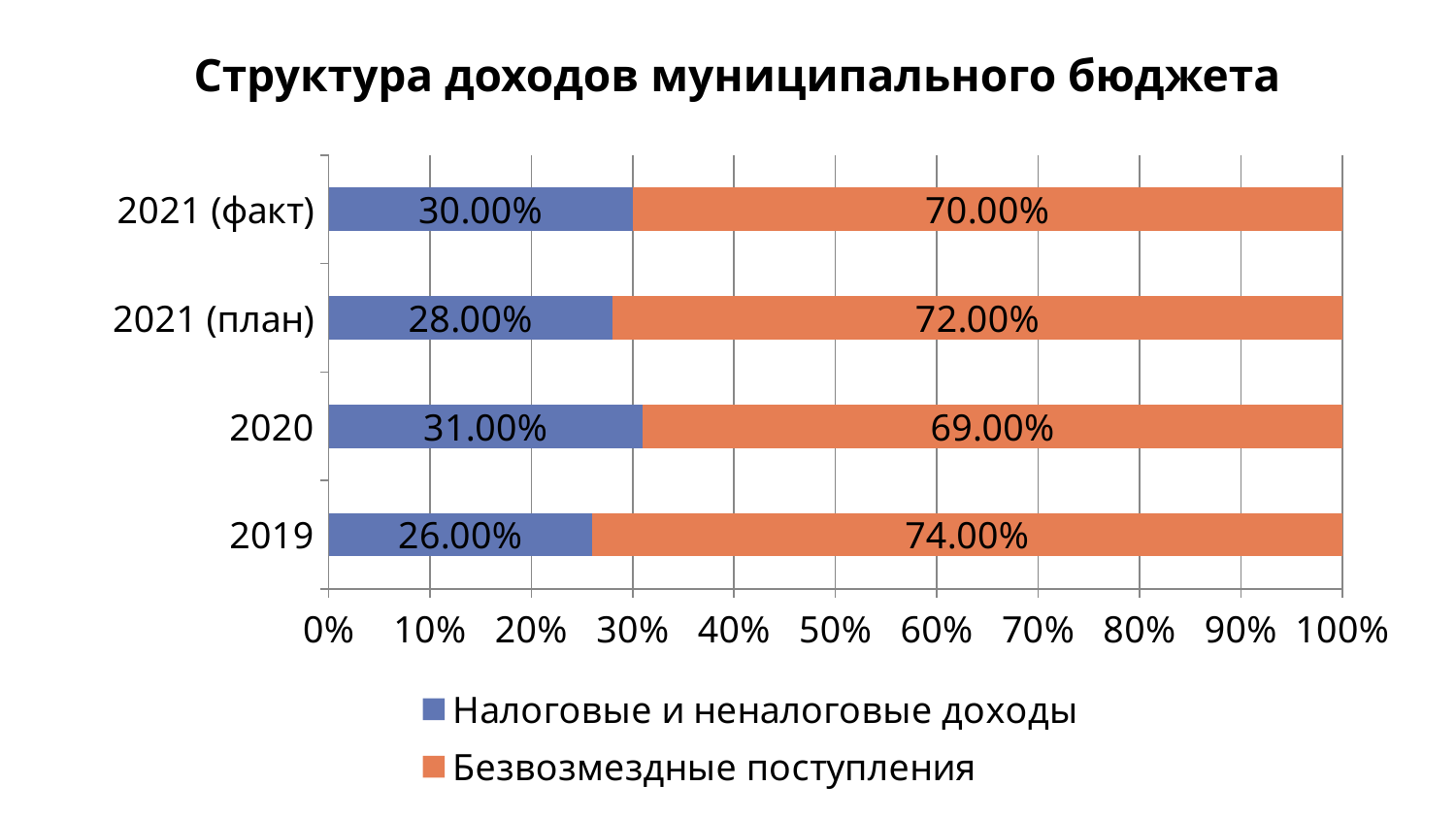
What is the value of Безвозмездные поступления for 2021 (план)? 72.00% What is the difference between Безвозмездные поступления for 2019 and for 2021 (факт)? 4.00% How many series does the legend list? 2 What is the title of the chart? Структура доходов муниципального бюджета Which category has the lowest value for Безвозмездные поступления? 2020 Which is larger: Налоговые и неналоговые доходы for 2021 (план) or for 2021 (факт)? 2021 (факт) What kind of chart is shown on the slide? Stacked bar chart How many categories are shown on the y axis? 4 What is the value of Налоговые и неналоговые доходы for 2020? 31.00% Which category has the highest value for Налоговые и неналоговые доходы? 2020 What is the value of Безвозмездные поступления for 2019? 74.00% What is the value of Налоговые и неналоговые доходы for 2021 (факт)? 30.00%